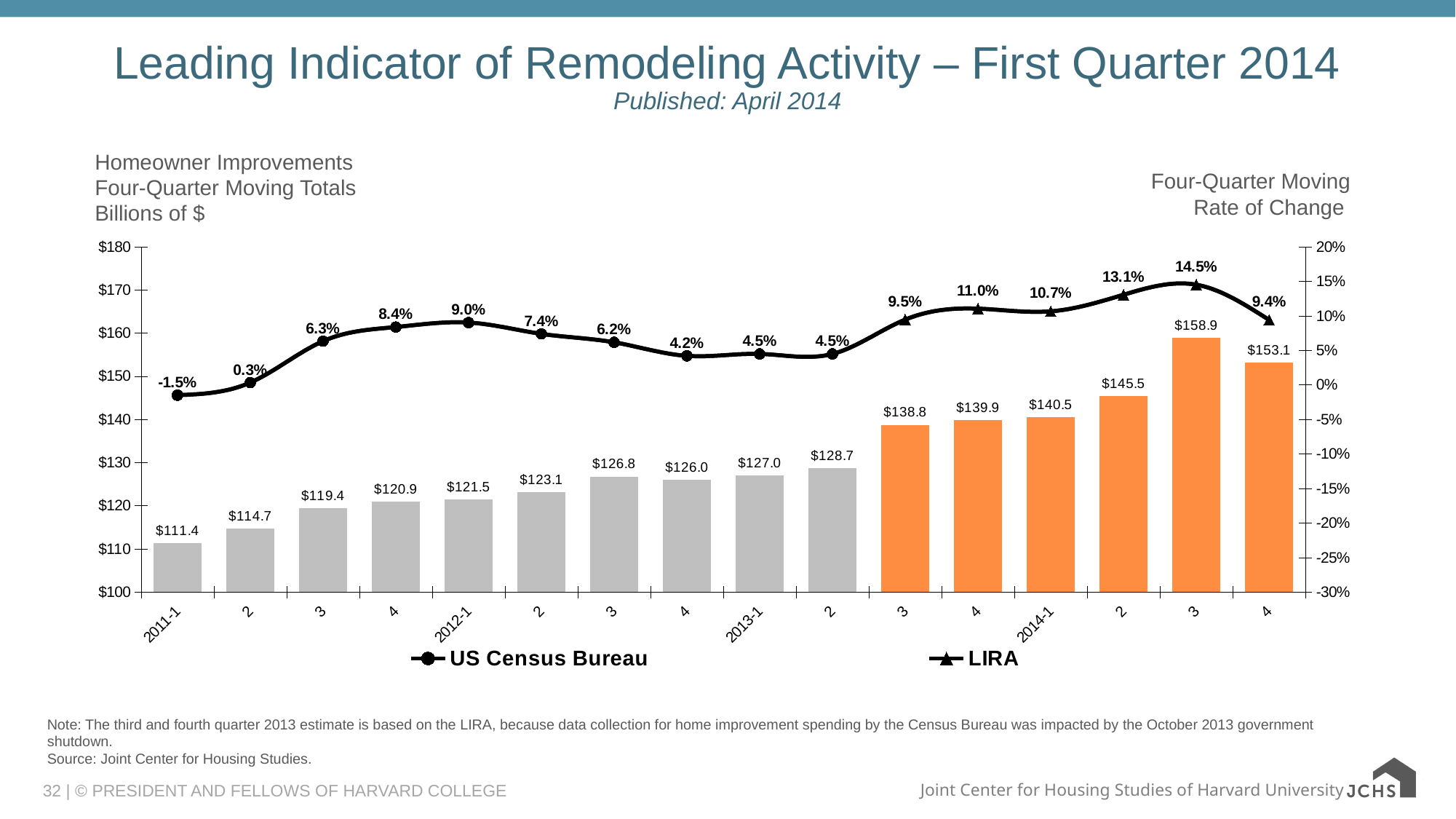
What is the four-quarter moving rate of change for 2014-3? 14.5% How many series does the legend list? 2 Which quarter has the lowest four-quarter moving rate of change? 2011-1 What is the four-quarter moving total for 2011-1? $111.4 What is the four-quarter moving total for 2014-1? $140.5 Does the rate of change rise or fall from 2012-1 to 2012-4? Fall What kind of chart is shown on the slide? Combined bar and line chart How many quarters are shown on the x axis? 16 Which quarter has the highest four-quarter moving total bar? 2014-3 What is the difference in the rate of change between 2014-2 and 2014-1? 2.4 percentage points Which has the larger four-quarter moving total, 2012-3 or 2012-4? 2012-3 What is the difference between the four-quarter moving totals for 2014-3 and 2014-4? $5.8